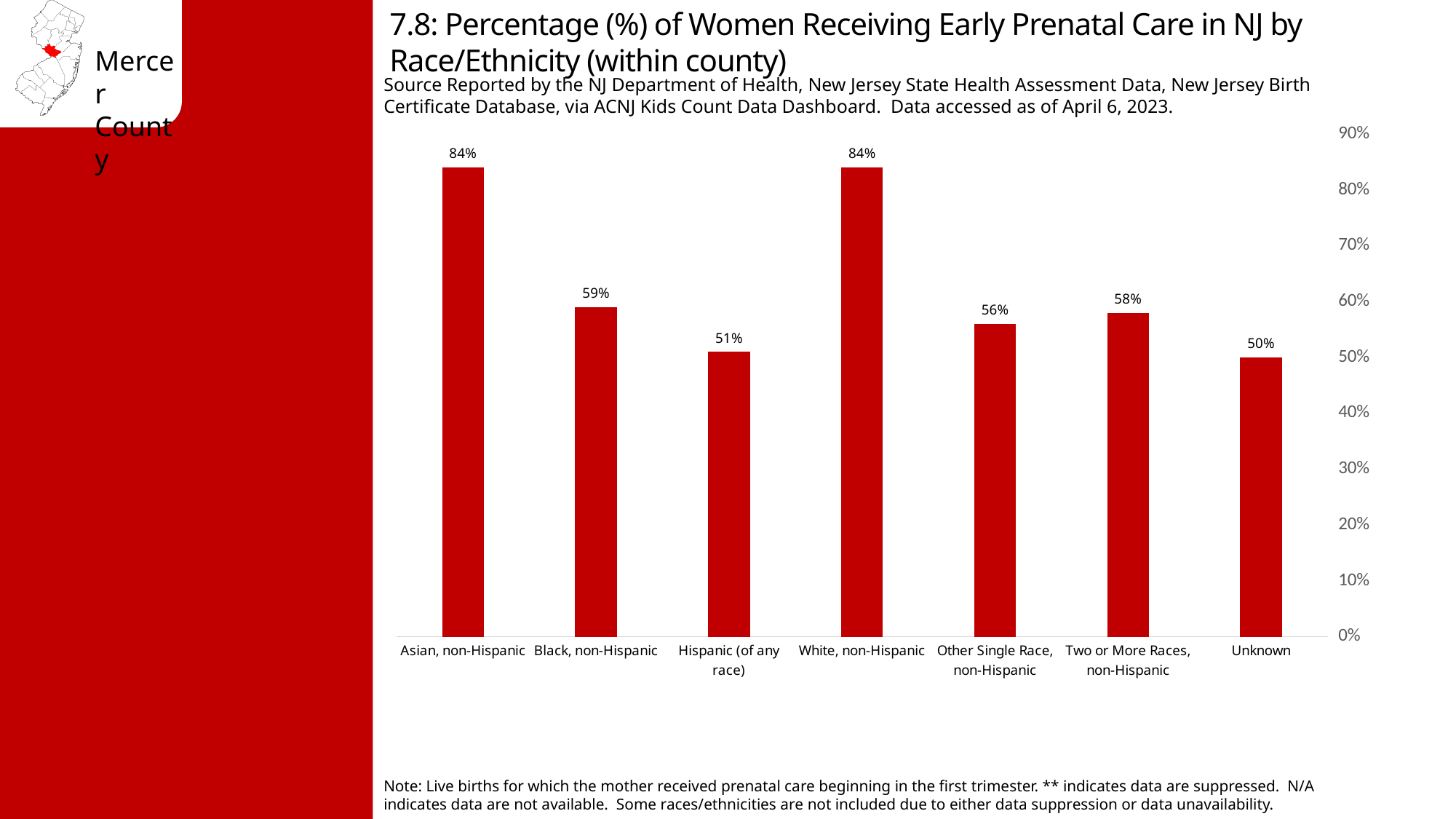
Is the value for Other Single Race, non-Hispanic greater or less than 60%? less What is the difference between the values for White, non-Hispanic and Other Single Race, non-Hispanic? 28 percentage points What is the value shown for Unknown? 50% Which is larger, the value for Black, non-Hispanic or the value for Hispanic (of any race)? Black, non-Hispanic What is the value shown for Black, non-Hispanic? 59% What is the percentage of women receiving early prenatal care for Asian, non-Hispanic? 84% What is the value shown for Two or More Races, non-Hispanic? 58% What type of chart is shown on the slide? Bar chart Which category has the lowest percentage of women receiving early prenatal care? Unknown What is the highest value shown on the vertical axis? 90% What is the value shown for Hispanic (of any race)? 51% How many race/ethnicity categories are plotted in the chart? 7